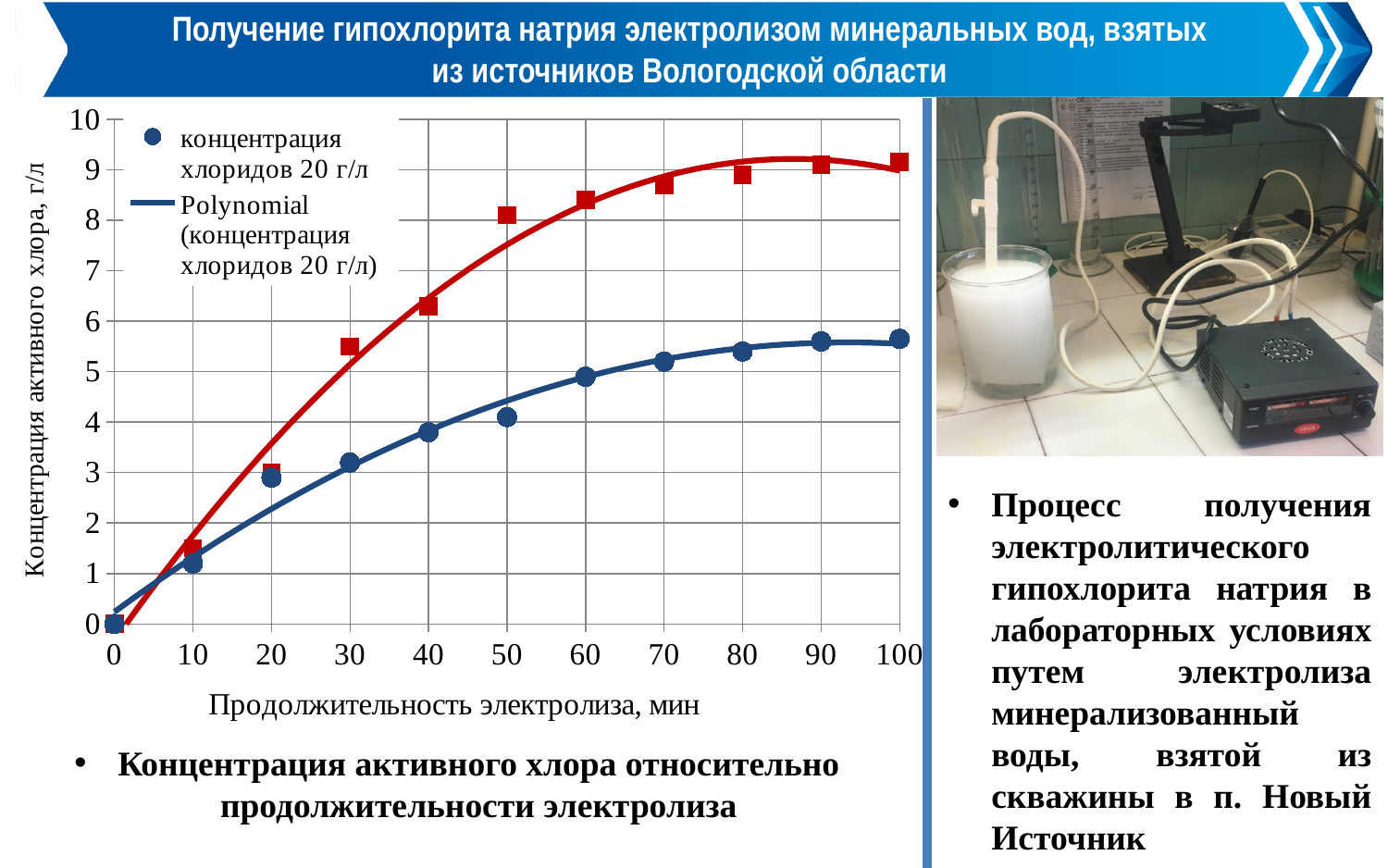
What is the title of the y axis of the chart? Концентрация активного хлора, г/л Is the value of the blue circle series at 60 min greater or less than 4? greater At 50 min, which series has the higher value, the red square series or the blue circle series? red square series What is the title of the x axis of the chart? Продолжительность электролиза, мин How many data points does the blue circle series have? 11 Is the value of the red square series at 50 min greater or less than 7? greater Do the values of the blue circle series rise or fall as electrolysis duration increases? rise What kind of chart is shown on the slide? scatter chart How many entries does the chart legend list? 2 What is the value of the blue circle series at 0 min? 0 Is the value of the red square series at 80 min greater or less than 8? greater